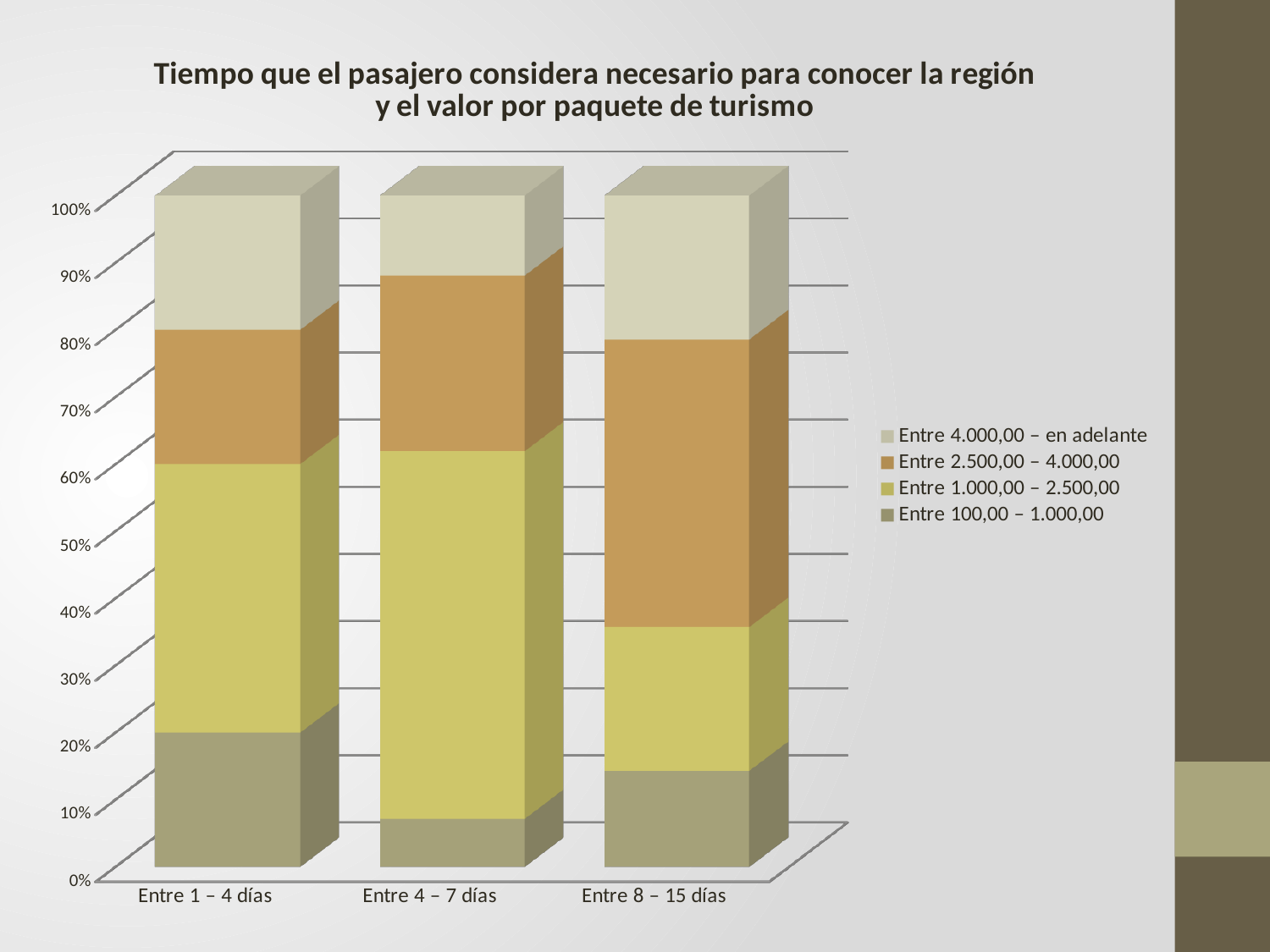
What kind of chart is shown on the slide? Stacked bar chart Which category has the largest "Entre 100,00 – 1.000,00" segment? Entre 1 – 4 días How many series does the chart's legend list? 4 How many categories are shown on the x axis of the chart? 3 Which category has the largest "Entre 1.000,00 – 2.500,00" segment? Entre 4 – 7 días Is the "Entre 1.000,00 – 2.500,00" segment for "Entre 4 – 7 días" greater or less than 50% of the bar? greater Which category has the smallest "Entre 100,00 – 1.000,00" segment? Entre 4 – 7 días Which legend entry represents the bottom segment of each bar? Entre 100,00 – 1.000,00 Is the "Entre 2.500,00 – 4.000,00" segment for "Entre 8 – 15 días" larger or smaller than the same segment for "Entre 1 – 4 días"? larger What is the title of the chart? Tiempo que el pasajero considera necesario para conocer la región y el valor por paquete de turismo Which category has the smallest "Entre 1.000,00 – 2.500,00" segment? Entre 8 – 15 días Which category has the largest "Entre 2.500,00 – 4.000,00" segment? Entre 8 – 15 días